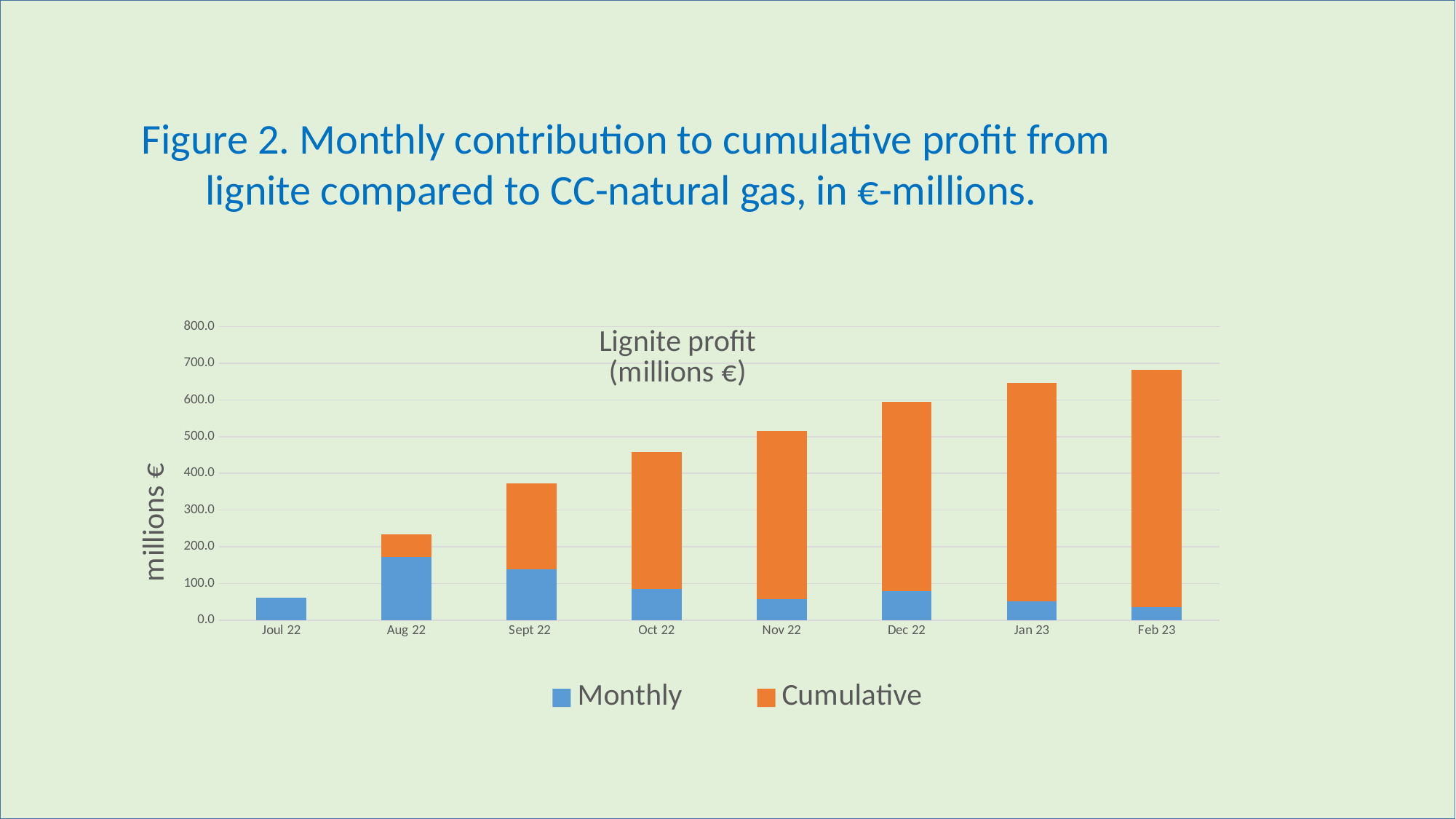
Which month has the largest Monthly (blue) segment? Aug 22 Do the total bar heights rise or fall from Joul 22 to Feb 23? rise Which month has the tallest stacked bar? Feb 23 Is the Monthly segment for Aug 22 greater or less than 100? greater How many series does the chart's legend list? 2 Which month has the shortest bar? Joul 22 How many months are shown on the x axis of the chart? 8 What kind of chart is shown on the slide? stacked bar chart What is the title printed inside the chart area? Lignite profit (millions €) Is the total bar height for Feb 23 greater or less than 600? greater What are the two series named in the legend? Monthly and Cumulative Is the value for Joul 22 greater or less than 100? less